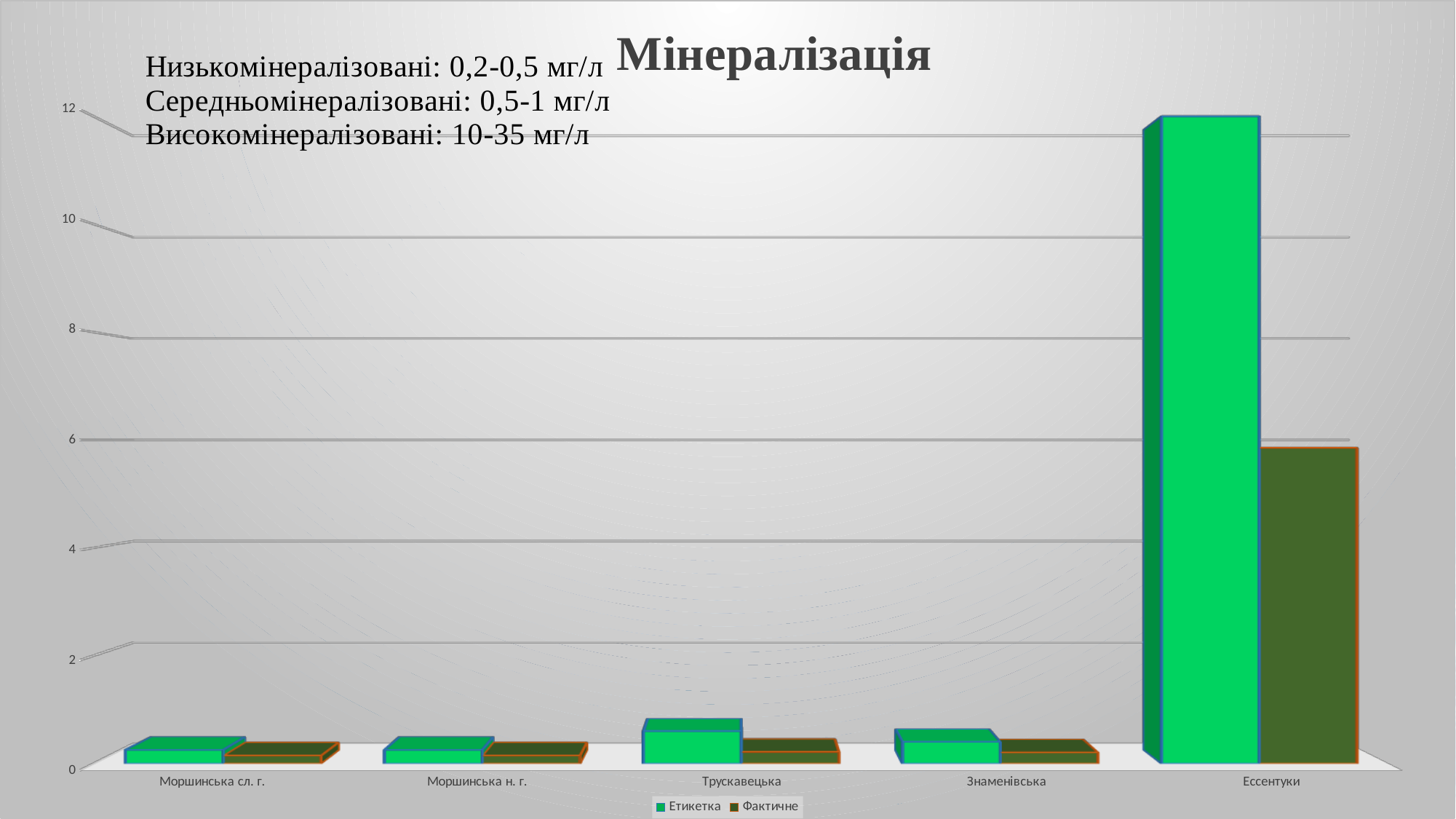
Is the Етикетка value for Трускавецька greater or less than 2? less How many categories are shown on the x axis of the chart? 5 Is the Фактичне value for Ессентуки greater or less than 4? greater Which is larger: the Етикетка value for Трускавецька or the Етикетка value for Моршинська сл. г.? Трускавецька For Ессентуки, which is larger: the Етикетка value or the Фактичне value? Етикетка What is the title of the chart? Мінералізація How many series does the chart legend list? 2 What kind of chart is shown on the slide? bar chart Is the Етикетка value for Ессентуки greater or less than 10? greater Which category has the highest Етикетка value? Ессентуки What are the two series names listed in the chart legend? Етикетка and Фактичне Which category has the highest Фактичне value? Ессентуки